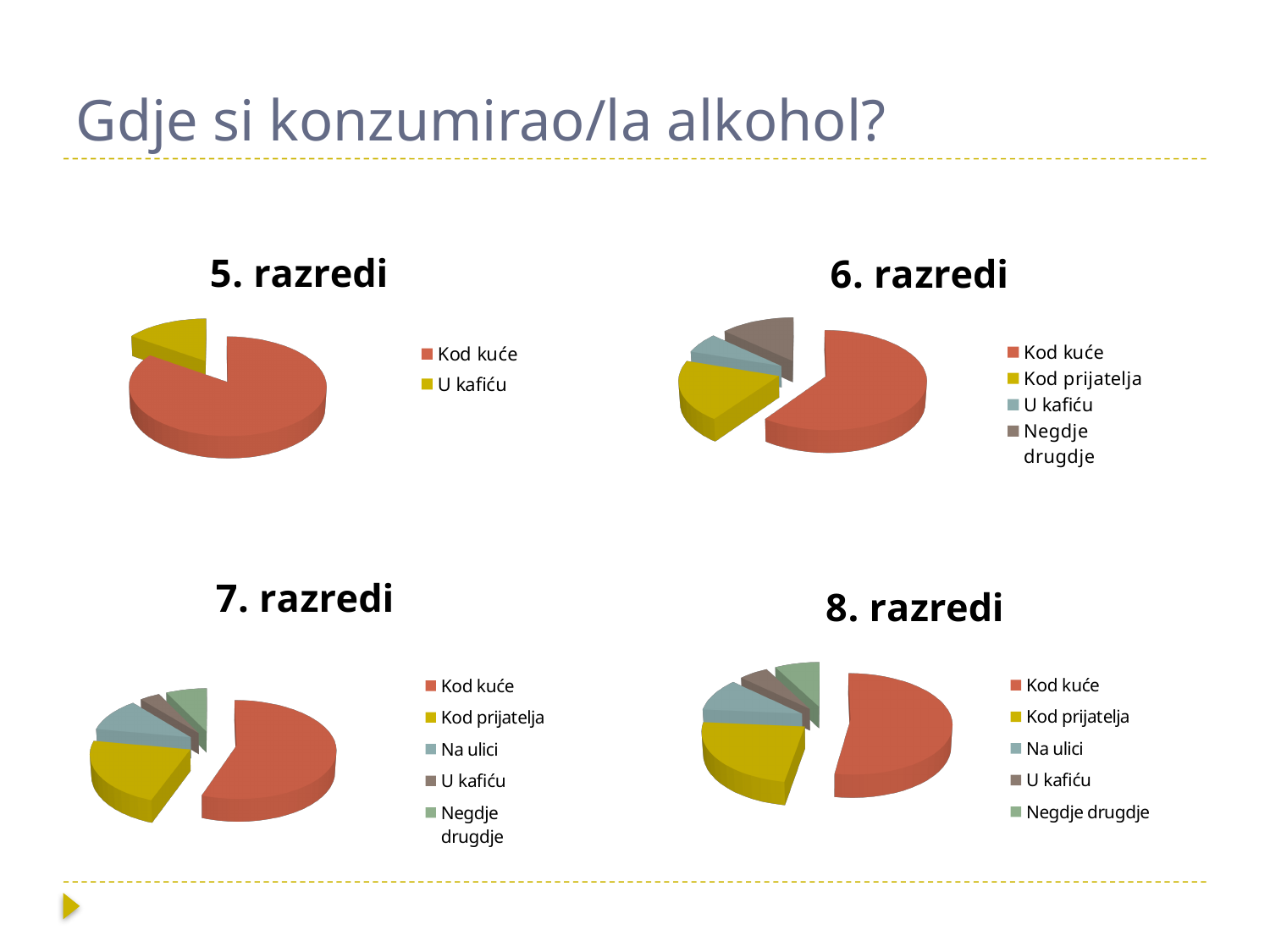
In the "7. razredi" chart, how many categories does the legend list? 5 In the "5. razredi" chart, which category has the largest slice? Kod kuće In the "7. razredi" chart, which category has the largest slice? Kod kuće In the "8. razredi" chart, what colour is the Kod kuće slice? red In the "6. razredi" chart, which category has the largest slice? Kod kuće In the "6. razredi" chart, which slice is larger, Kod kuće or Kod prijatelja? Kod kuće In the "8. razredi" chart, which slice is larger, Kod prijatelja or Na ulici? Kod prijatelja In the "5. razredi" chart, how many categories does the legend list? 2 How many pie charts are shown on the slide? 4 What kind of chart is the "5. razredi" chart? pie chart In the "5. razredi" chart, which category has the smallest slice? U kafiću In the "6. razredi" chart, how many categories does the legend list? 4